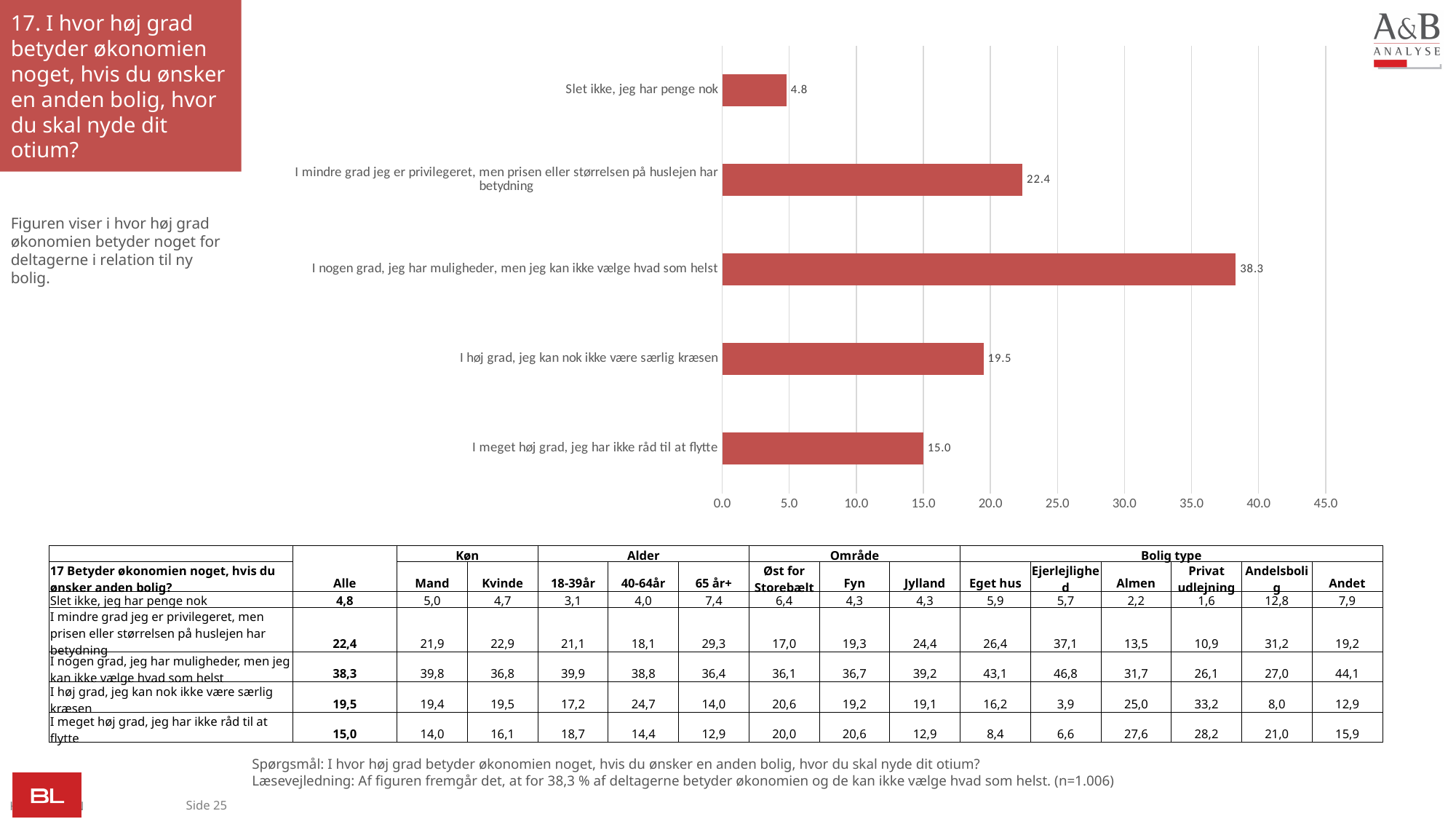
Is the value for "I mindre grad jeg er privilegeret, men prisen eller størrelsen på huslejen har betydning" greater or less than 20.0? greater What is the value for "I høj grad, jeg kan nok ikke være særlig kræsen"? 19.5 What is the value for "I nogen grad, jeg har muligheder, men jeg kan ikke vælge hvad som helst"? 38.3 What is the difference between the values for "I nogen grad, jeg har muligheder, men jeg kan ikke vælge hvad som helst" and "I mindre grad jeg er privilegeret, men prisen eller størrelsen på huslejen har betydning"? 15.9 What kind of chart is shown on the slide? bar chart What is the maximum value shown on the chart's value axis? 45.0 What is the value for "Slet ikke, jeg har penge nok"? 4.8 Which category has the lowest value? Slet ikke, jeg har penge nok Which is larger: the value for "I høj grad, jeg kan nok ikke være særlig kræsen" or the value for "I meget høj grad, jeg har ikke råd til at flytte"? I høj grad, jeg kan nok ikke være særlig kræsen How many categories are shown in the bar chart? 5 Which category has the highest value? I nogen grad, jeg har muligheder, men jeg kan ikke vælge hvad som helst What is the value for "I meget høj grad, jeg har ikke råd til at flytte"? 15.0